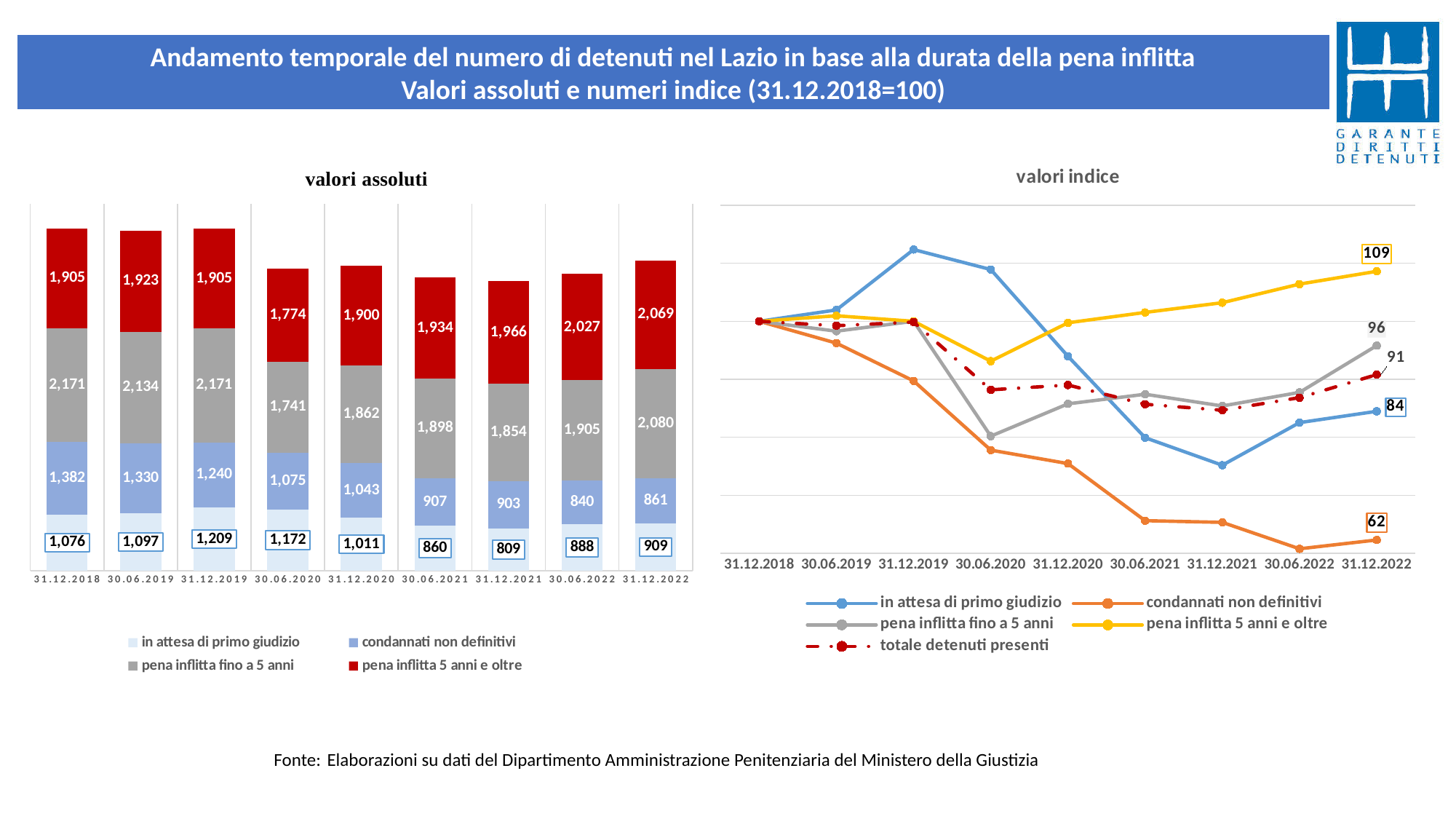
In the 'valori assoluti' chart, what is the value for 'in attesa di primo giudizio' at 31.12.2021? 809 In the 'valori assoluti' chart, at which date is the value for 'in attesa di primo giudizio' lowest? 31.12.2021 In the 'valori assoluti' chart, at which date is the value for 'pena inflitta 5 anni e oltre' highest? 31.12.2022 In the 'valori assoluti' chart, which is larger: 'condannati non definitivi' at 31.12.2018 or at 31.12.2019? 31.12.2018 In the 'valori indice' chart, what is the value labelled for 'pena inflitta 5 anni e oltre' at 31.12.2022? 109 How many series does the legend of the 'valori indice' chart list? 5 How many dates are shown on the x axis of the 'valori assoluti' chart? 9 In the 'valori assoluti' chart, what is the total of the stacked bar for 31.12.2018? 6,534 In the 'valori assoluti' chart, what is the value for 'pena inflitta 5 anni e oltre' at 31.12.2022? 2,069 In the 'valori assoluti' chart, what is the difference between the 'pena inflitta fino a 5 anni' values at 31.12.2022 and 30.06.2022? 175 What kind of chart is the 'valori assoluti' chart? bar chart What kind of chart is the 'valori indice' chart? line chart